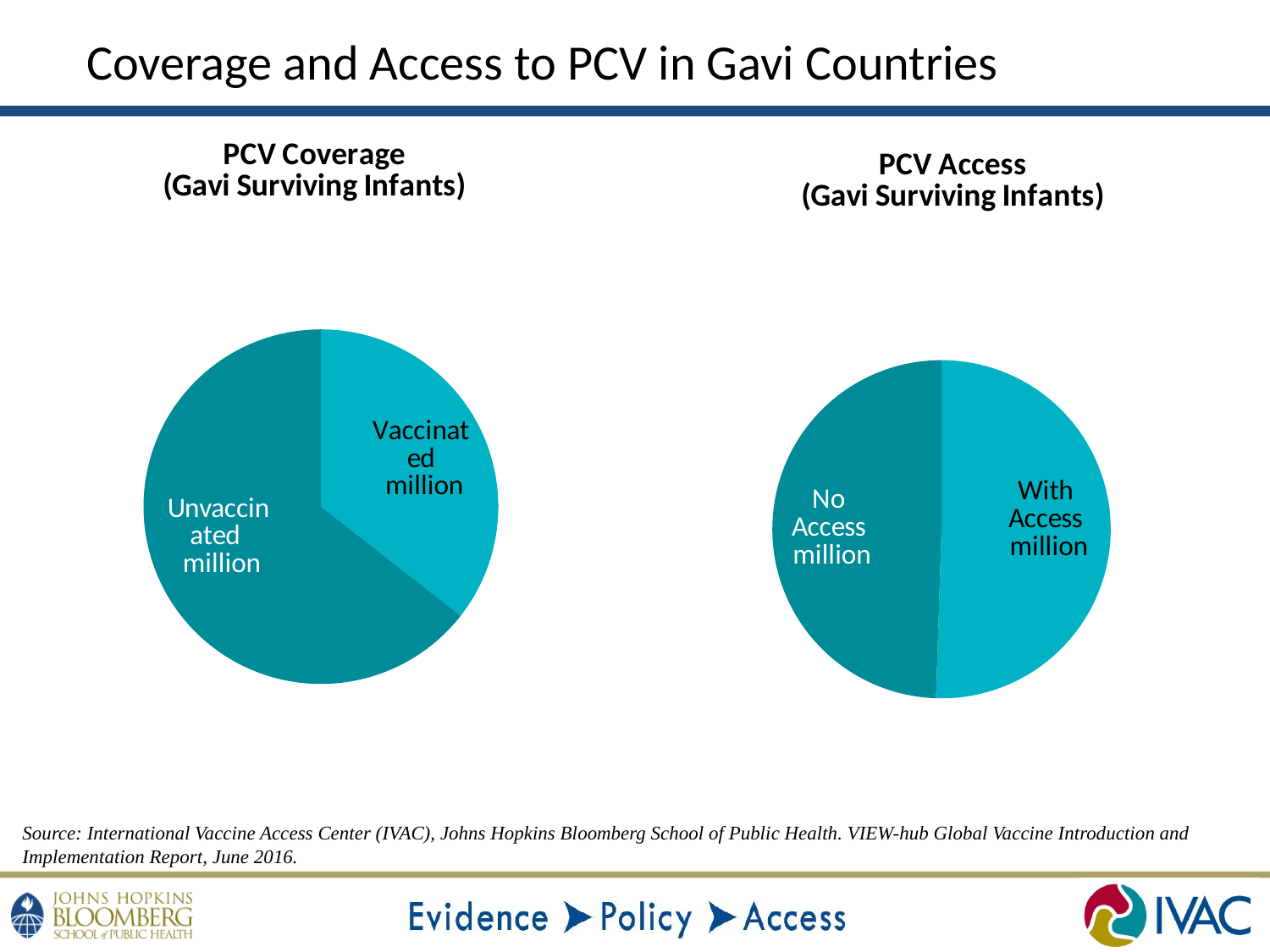
In the PCV Coverage (Gavi Surviving Infants) chart, which slice is the largest? Unvaccinated What kind of chart is the PCV Coverage (Gavi Surviving Infants) chart? Pie chart In the PCV Coverage (Gavi Surviving Infants) chart, which slice is the smallest? Vaccinated How many pie charts are shown on the slide? 2 What kind of chart is the PCV Access (Gavi Surviving Infants) chart? Pie chart How many slices does the PCV Coverage (Gavi Surviving Infants) pie chart have? 2 In the PCV Coverage (Gavi Surviving Infants) chart, which slice is larger, Vaccinated or Unvaccinated? Unvaccinated How many slices does the PCV Access (Gavi Surviving Infants) pie chart have? 2 What are the two slice labels in the PCV Access (Gavi Surviving Infants) chart? No Access and With Access What is the title of the pie chart on the left of the slide? PCV Coverage (Gavi Surviving Infants)